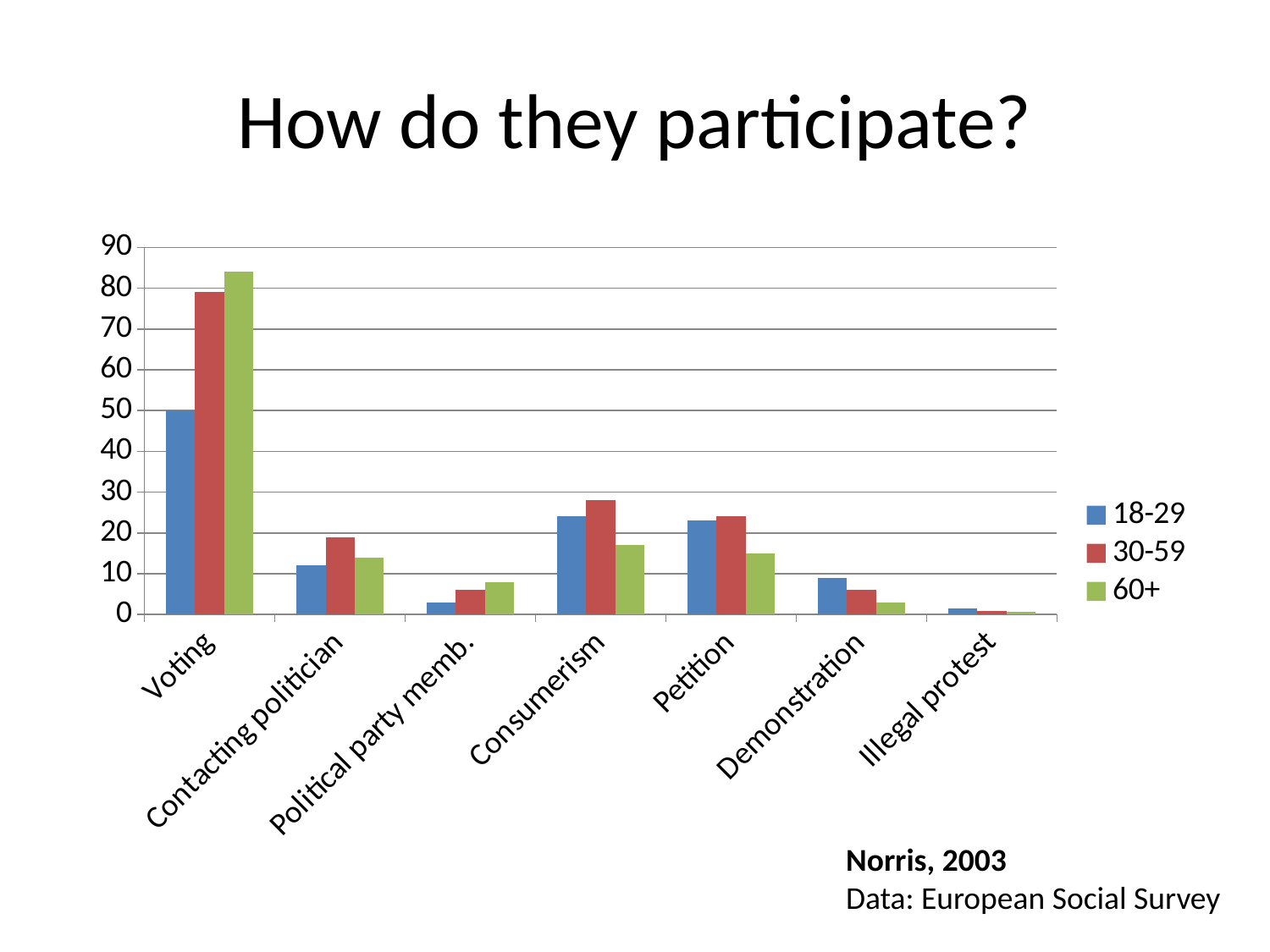
Which colour represents the 30-59 series in the legend? red For Voting, which series has the larger value, 18-29 or 30-59? 30-59 How many series does the legend list? 3 What is the title of the chart on the slide? How do they participate? For Demonstration, which series has the larger value, 18-29 or 60+? 18-29 What kind of chart is shown on the slide? bar chart Is the value for Political party memb. in the 18-29 series greater or less than 10? less Which category has the highest value for the 60+ series? Voting Is the value for Contacting politician in the 30-59 series greater or less than 10? greater Which category has the lowest value for the 30-59 series? Illegal protest How many participation categories are shown on the x axis? 7 Is the value for Voting in the 60+ series greater or less than 80? greater